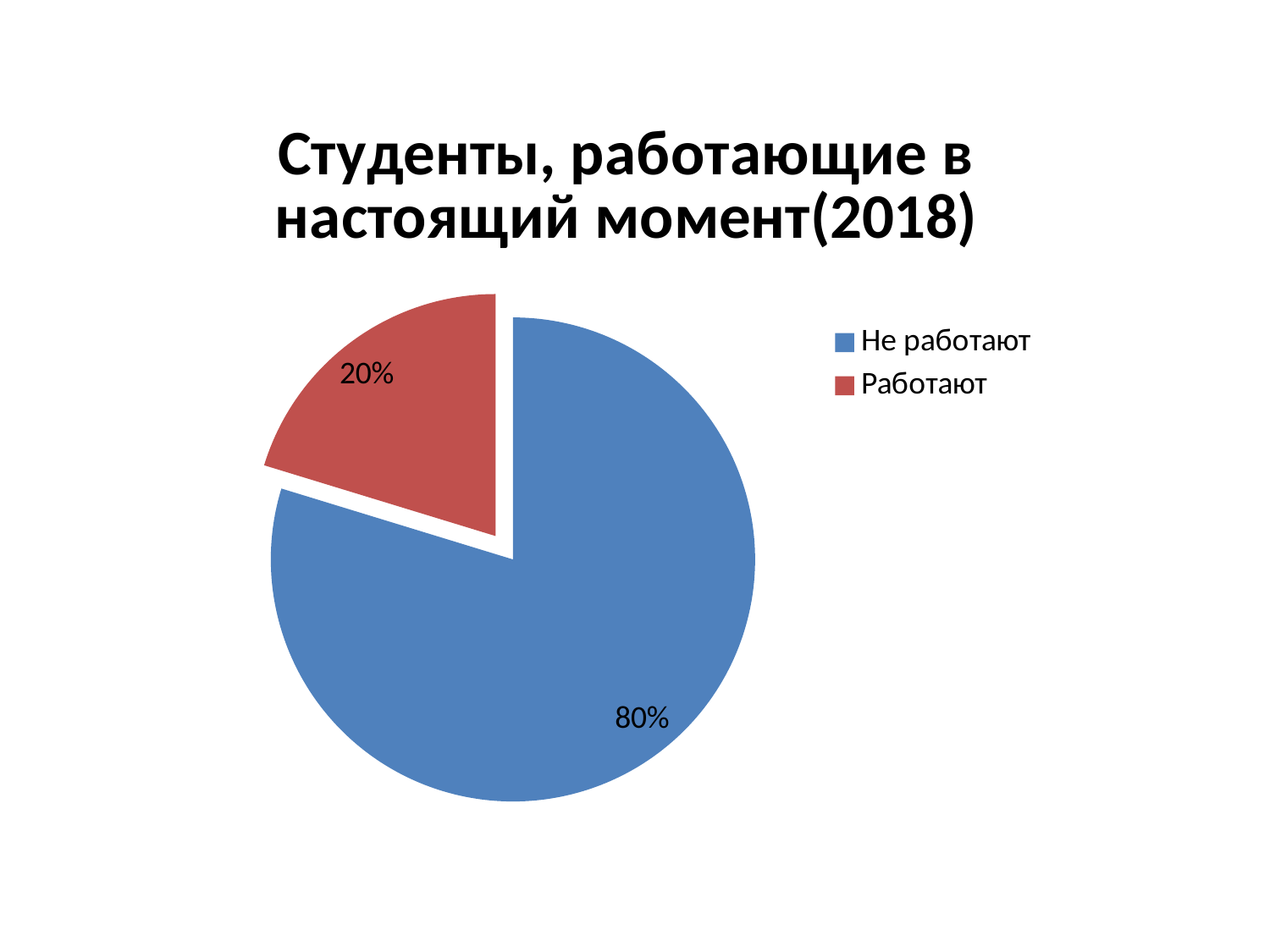
What share of the pie does the "Работают" slice represent? 20% How many entries does the legend list? 2 What percentage is shown for "Работают"? 20% What percentage is shown for "Не работают"? 80% Which category has the largest slice of the pie? Не работают Which is larger, the share for "Работают" or the share for "Не работают"? Не работают How many categories does the pie chart have? 2 What is the title of the chart? Студенты, работающие в настоящий момент(2018) What type of chart is shown on the slide? pie chart What colour is the "Работают" slice? red Which category has the smallest slice of the pie? Работают What is the difference in percentage points between "Не работают" and "Работают"? 60